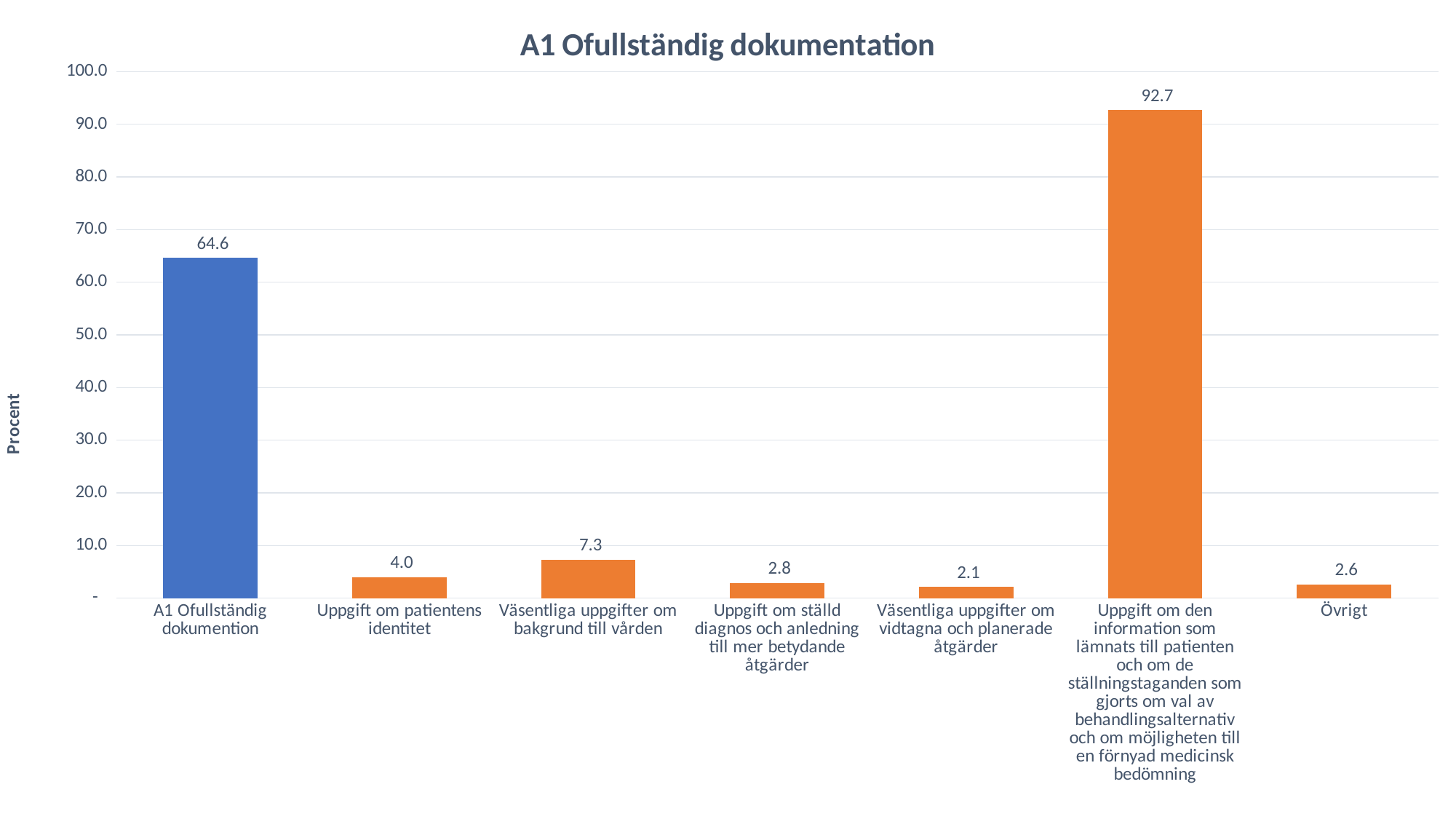
What is the value for "A1 Ofullständig dokumention"? 64.6 Which category has the highest value? Uppgift om den information som lämnats till patienten och om de ställningstaganden som gjorts om val av behandlingsalternativ och om möjligheten till en förnyad medicinsk bedömning What is the value for "Väsentliga uppgifter om bakgrund till vården"? 7.3 What is the value for "Uppgift om patientens identitet"? 4.0 What is the title of the chart? A1 Ofullständig dokumentation Which is larger: the value for "Uppgift om ställd diagnos och anledning till mer betydande åtgärder" or the value for "Övrigt"? Uppgift om ställd diagnos och anledning till mer betydande åtgärder What is the difference between the value for "Väsentliga uppgifter om bakgrund till vården" and the value for "Uppgift om patientens identitet"? 3.3 Which category has the lowest value? Väsentliga uppgifter om vidtagna och planerade åtgärder What is the value for "Övrigt"? 2.6 Is the value for "A1 Ofullständig dokumention" greater or less than 60.0? greater How many categories are shown on the x axis? 7 What kind of chart is shown on the slide? bar chart